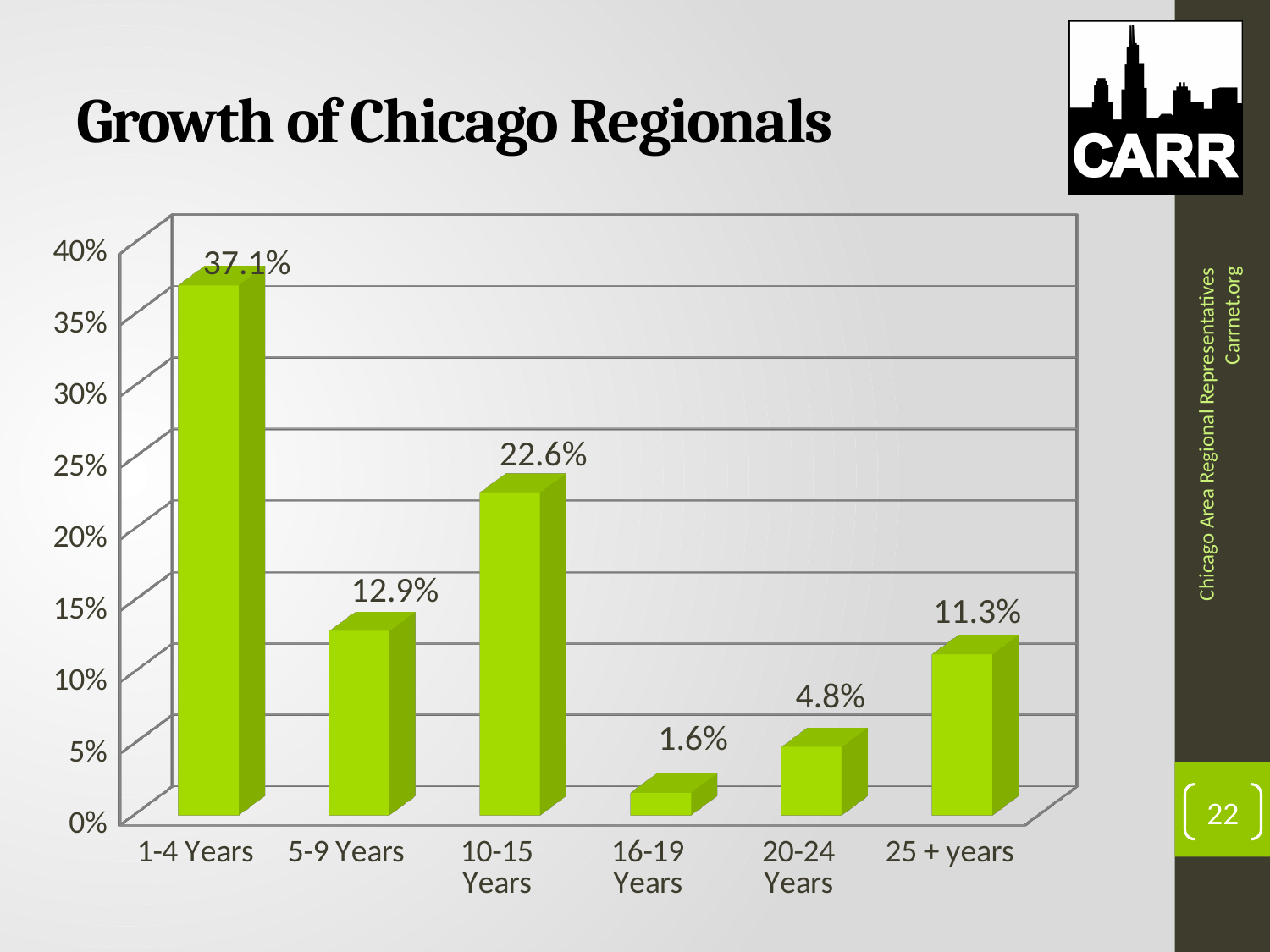
Which is larger, the value for 20-24 Years or the value for 16-19 Years? 20-24 Years Is the value for 5-9 Years greater or less than 10%? greater What is the value for 25 + years? 11.3% How many categories are shown on the x axis? 6 What is the difference between the values for 5-9 Years and 25 + years? 1.6% What is the difference between the values for 1-4 Years and 10-15 Years? 14.5% Which category has the lowest value? 16-19 Years What is the value for 10-15 Years? 22.6% What kind of chart is shown on the slide? bar chart Which category has the highest value? 1-4 Years What is the value for 1-4 Years? 37.1% What is the title of the slide? Growth of Chicago Regionals